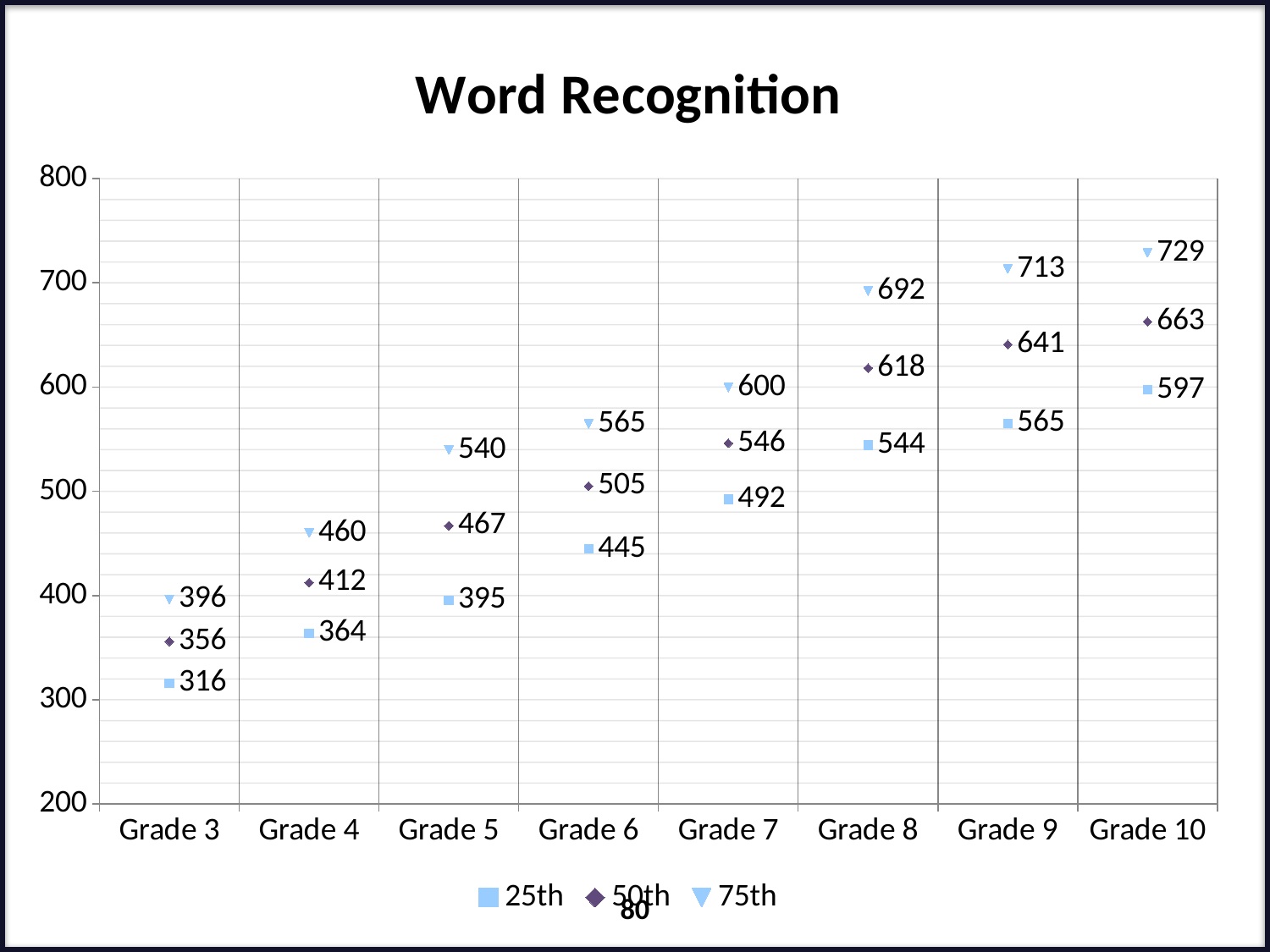
Do the 50th percentile values rise or fall from Grade 3 to Grade 10? Rise What is the 75th percentile value for Grade 8? 692 Which is larger: the 50th percentile value for Grade 7 or the 25th percentile value for Grade 9? 25th percentile value for Grade 9 How many series does the legend list? 3 How many grades are shown on the x axis? 8 What is the 25th percentile value for Grade 3? 316 What kind of chart is this? Scatter chart Which grade has the lowest 25th percentile value? Grade 3 What is the 50th percentile value for Grade 6? 505 What is the title of the chart? Word Recognition What is the difference between the 75th and 25th percentile values for Grade 10? 132 Which grade has the highest 75th percentile value? Grade 10